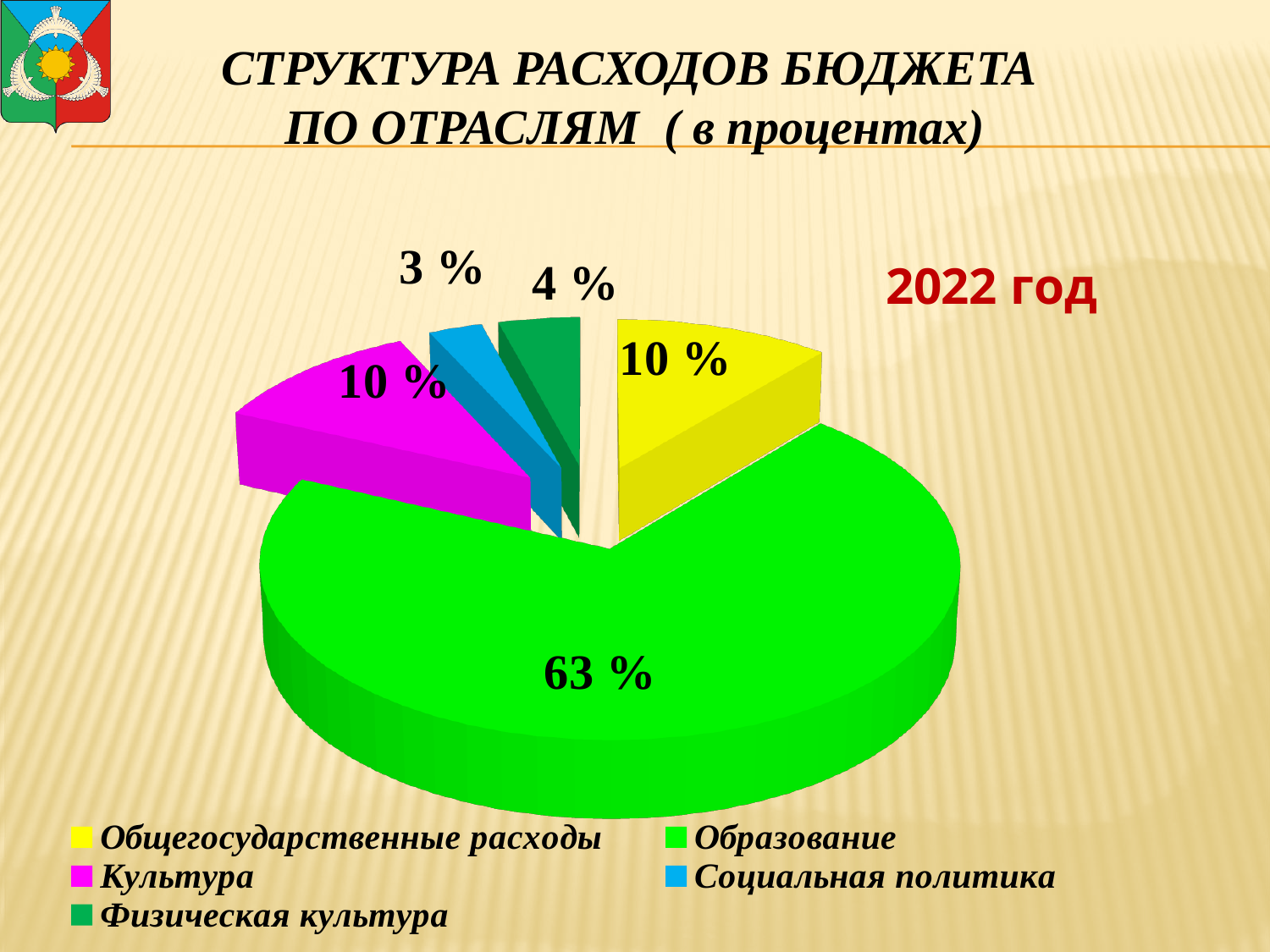
What share of budget expenditure goes to Физическая культура? 4 % What share of budget expenditure goes to Культура? 10 % Which sector has the largest share of budget expenditure? Образование Which year does the chart refer to? 2022 год Which sector has the smallest share of budget expenditure? Социальная политика Which has a larger share, Физическая культура or Социальная политика? Физическая культура What colour is the slice for Культура? magenta What share of budget expenditure goes to Образование? 63 % What kind of chart is shown on the slide? pie chart What share of budget expenditure goes to Социальная политика? 3 % How many sectors are shown in the pie chart? 5 What is the difference between the shares of Образование and Общегосударственные расходы? 53 %